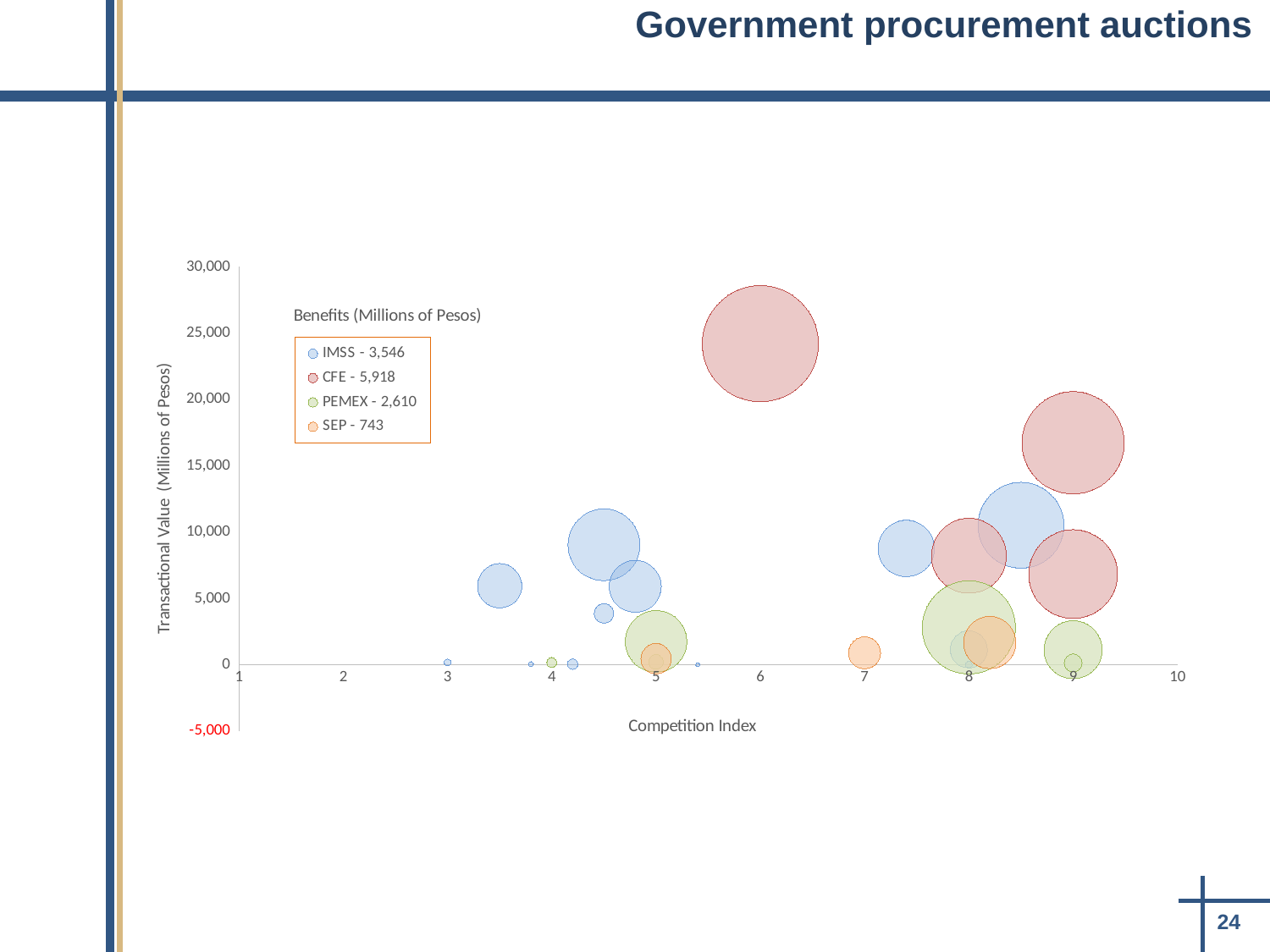
Which has a larger benefits value in the legend, PEMEX or SEP? PEMEX What benefits value (Millions of Pesos) does the legend give for PEMEX? 2,610 What benefits value (Millions of Pesos) does the legend give for SEP? 743 Which entity has the highest benefits value in the legend? CFE What is the difference between the benefits values for CFE and IMSS shown in the legend? 2,372 Is the transactional value of the highest CFE bubble (near competition index 6) greater or less than 20,000? greater What is the title of the x axis? Competition Index How many series does the legend list? 4 What benefits value (Millions of Pesos) does the legend give for CFE? 5,918 Which entity has the lowest benefits value in the legend? SEP What kind of chart is shown on the slide? Bubble chart What benefits value (Millions of Pesos) does the legend give for IMSS? 3,546